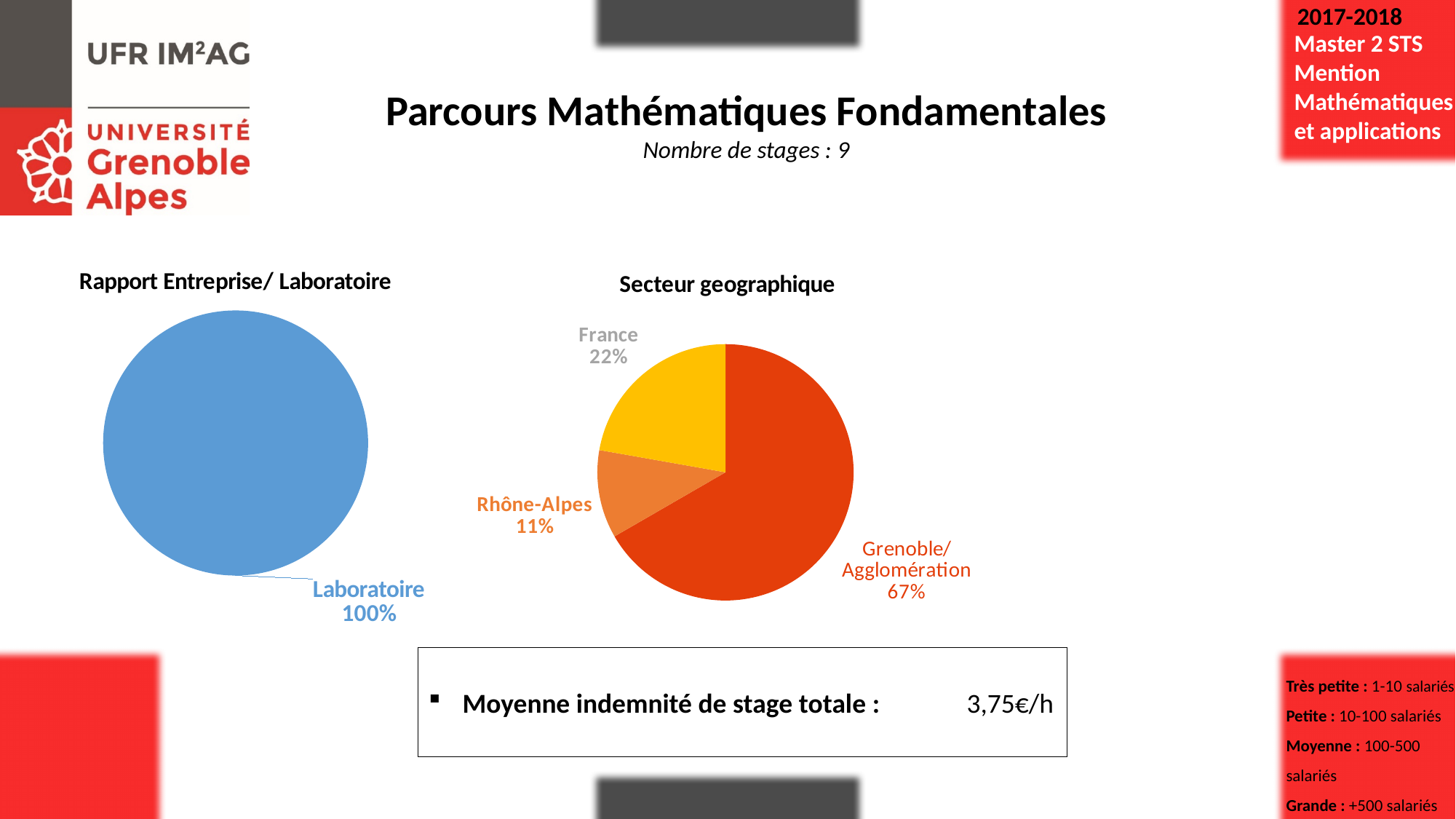
What is the title of the chart on the left of the slide? Rapport Entreprise/ Laboratoire In the 'Secteur geographique' chart, what share does Rhône-Alpes have? 11% How many labelled slices does the 'Rapport Entreprise/ Laboratoire' chart show? 1 In the 'Secteur geographique' chart, what is the difference in percentage points between Grenoble/Agglomération and France? 45 In the 'Secteur geographique' chart, which is larger, France or Rhône-Alpes? France How many slices does the 'Secteur geographique' chart have? 3 In the 'Secteur geographique' chart, what share does Grenoble/Agglomération have? 67% In the 'Rapport Entreprise/ Laboratoire' chart, what share does Laboratoire have? 100% In the 'Secteur geographique' chart, what share does France have? 22% In the 'Secteur geographique' chart, which sector has the largest share? Grenoble/Agglomération What kind of chart is the 'Secteur geographique' chart? Pie chart In the 'Secteur geographique' chart, which sector has the smallest share? Rhône-Alpes